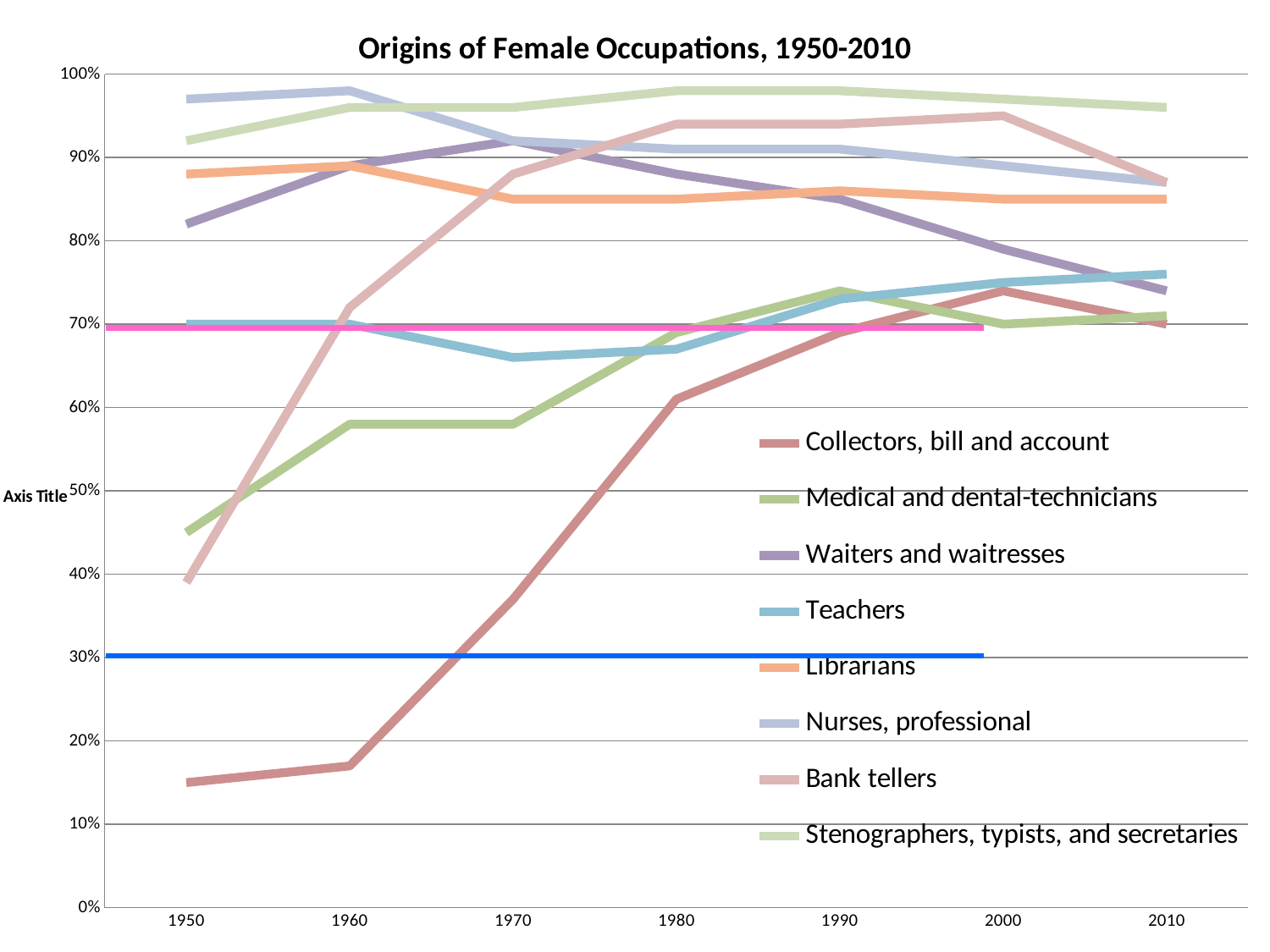
Is the value for Collectors, bill and account in 1950 greater or less than 20%? less Which series has the highest value in 1950? Nurses, professional How many years are marked along the x axis? 7 Is the value for Medical and dental-technicians in 1950 greater or less than 50%? less What kind of chart is shown on the slide? line chart What is the title of the chart? Origins of Female Occupations, 1950-2010 Is the value for Nurses, professional in 1960 greater or less than 90%? greater Which series has the lowest value in 1950? Collectors, bill and account Does the value for Collectors, bill and account rise or fall from 1950 to 2000? rise How many series does the legend list? 8